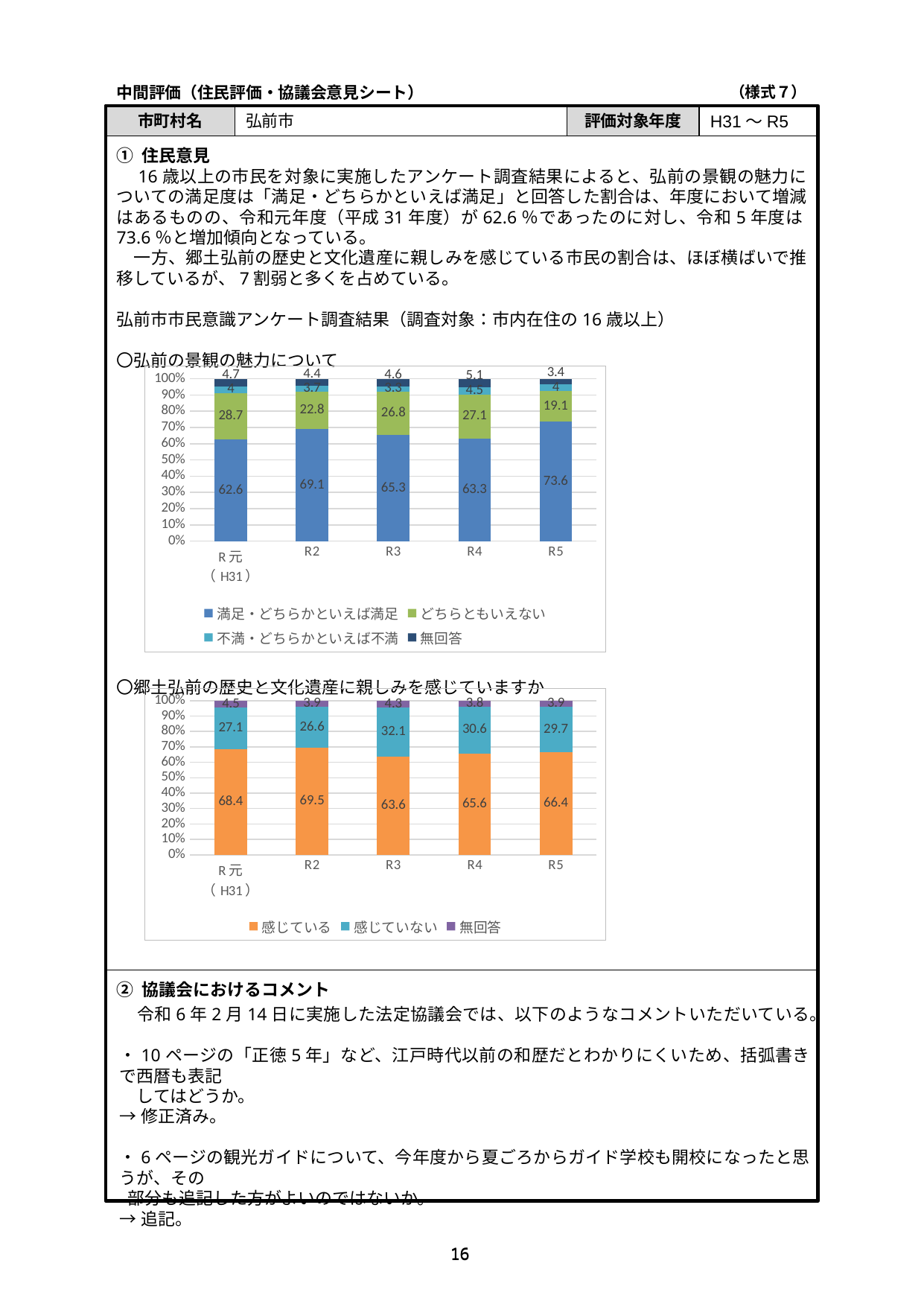
In the chart titled 郷土弘前の歴史と文化遺産に親しみを感じていますか, how many year categories are shown on the x axis? 5 In the chart titled 弘前の景観の魅力について, what is the difference between the 満足・どちらかといえば満足 values for R5 and R元(H31)? 11 In the chart titled 郷土弘前の歴史と文化遺産に親しみを感じていますか, what is the value of 感じていない for R4? 30.6 In the chart titled 弘前の景観の魅力について, which year has the lowest value for どちらともいえない? R5 In the chart titled 弘前の景観の魅力について, what is the value of どちらともいえない for R2? 22.8 What type of chart is the chart titled 郷土弘前の歴史と文化遺産に親しみを感じていますか? Stacked bar chart In the chart titled 郷土弘前の歴史と文化遺産に親しみを感じていますか, which year has the highest value for 感じていない? R3 In the chart titled 弘前の景観の魅力について, which year has the highest value for 満足・どちらかといえば満足? R5 In the chart titled 郷土弘前の歴史と文化遺産に親しみを感じていますか, what is the value of 感じている for R3? 63.6 In the chart titled 郷土弘前の歴史と文化遺産に親しみを感じていますか, is the 感じている value for R2 larger or smaller than for R3? larger In the chart titled 弘前の景観の魅力について, what is the value of 満足・どちらかといえば満足 for R5? 73.6 In the chart titled 弘前の景観の魅力について, how many series does the legend list? 4